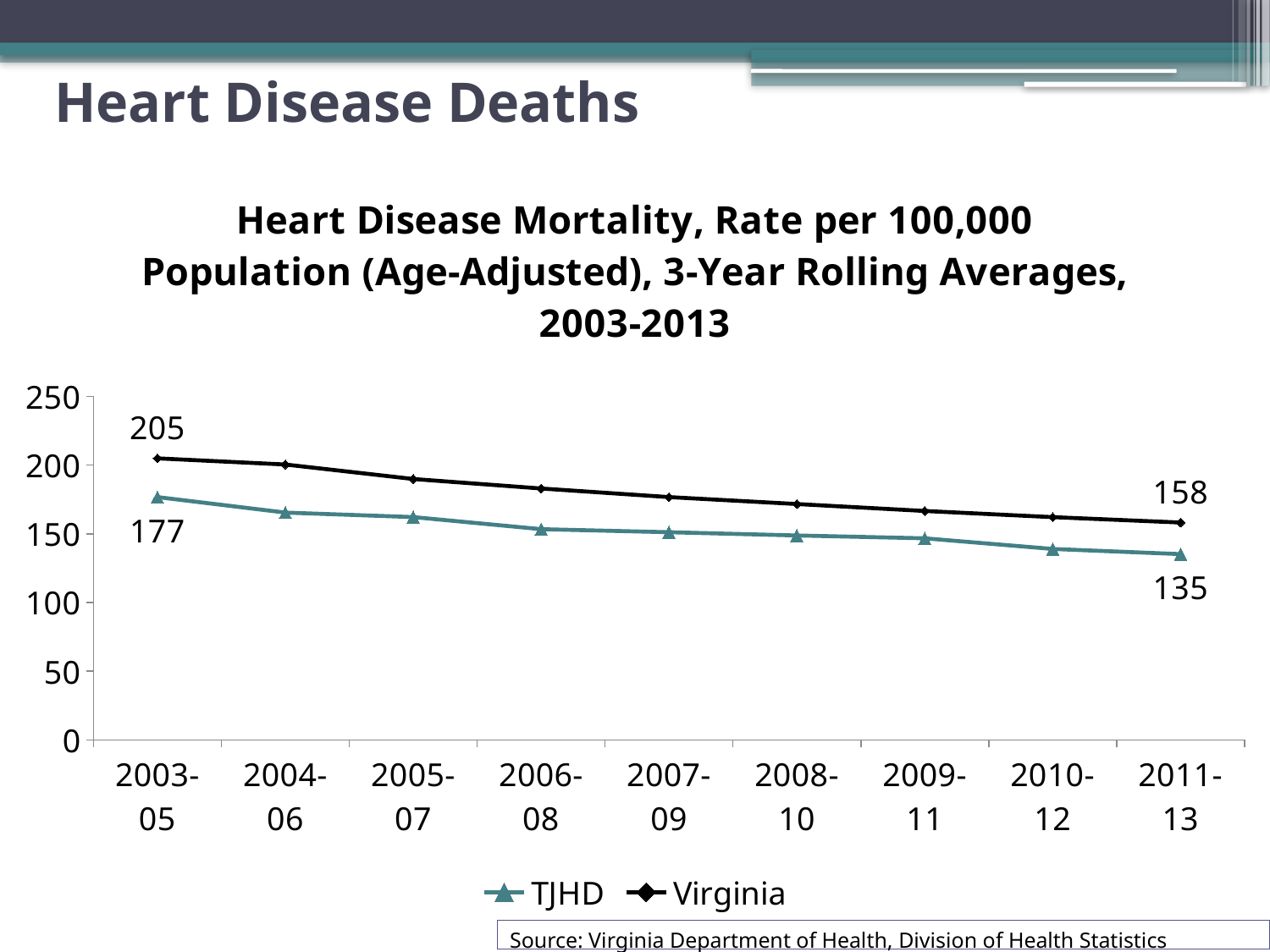
Is the TJHD value for 2006-08 greater or less than 200? less What is the TJHD heart disease mortality rate for 2011-13? 135 What is the difference between the Virginia and TJHD rates in 2011-13? 23 What kind of chart is shown on the slide? Line chart What is the Virginia heart disease mortality rate for 2011-13? 158 What is the TJHD heart disease mortality rate for 2003-05? 177 How many series does the legend list? 2 By how much did the TJHD rate fall from 2003-05 to 2011-13? 42 What is the Virginia heart disease mortality rate for 2003-05? 205 By how much did the Virginia rate fall from 2003-05 to 2011-13? 47 How many time periods are shown on the x axis? 9 Which series has the higher rate in 2007-09, TJHD or Virginia? Virginia